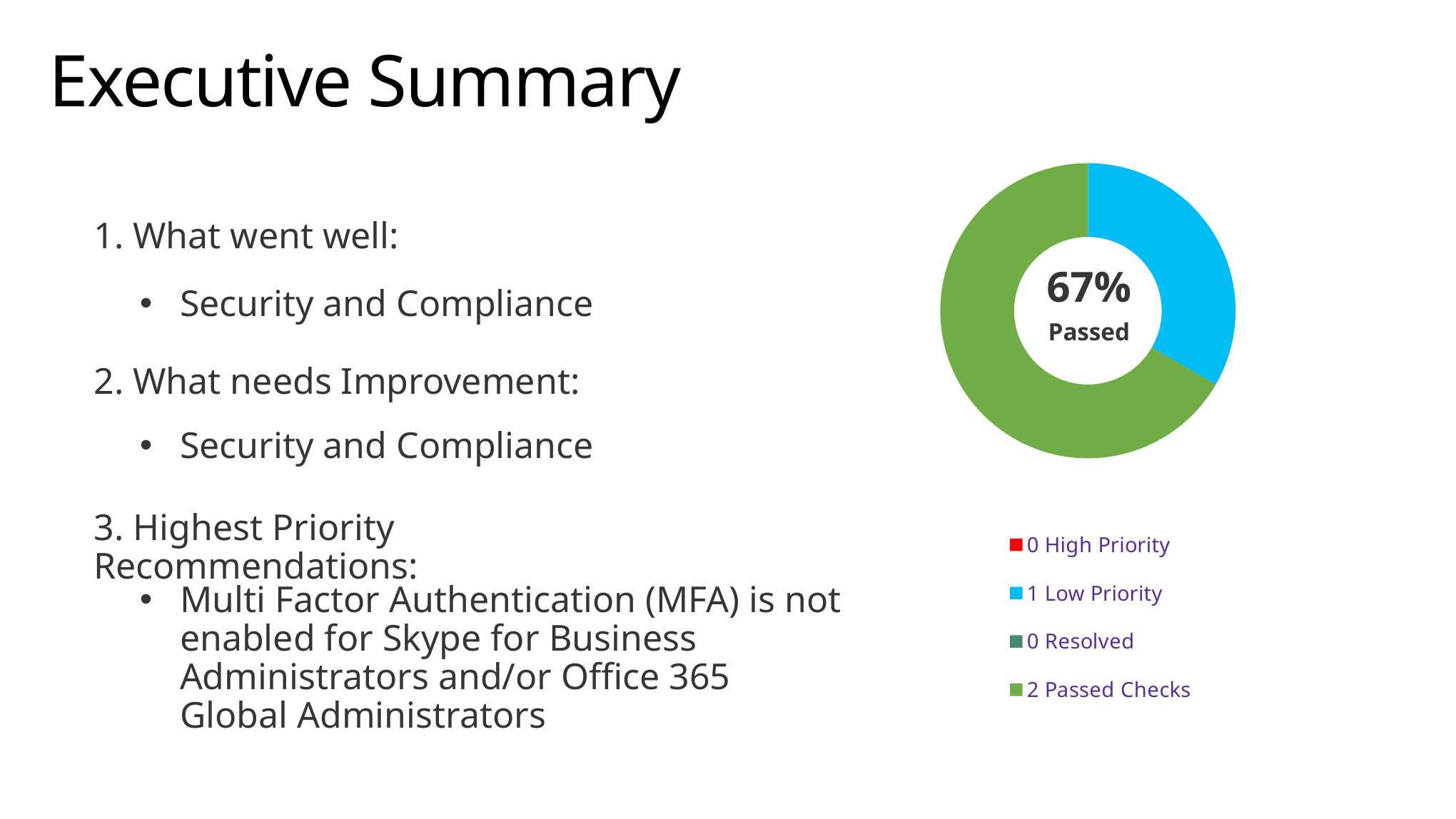
What kind of chart is shown on the slide? Donut chart How many Resolved items does the legend show? 0 How many High Priority items does the legend show? 0 How many Low Priority items does the legend show? 1 What colour represents Passed Checks in the donut chart? Green What word appears below the percentage in the centre of the donut chart? Passed How many Passed Checks does the legend show? 2 How many entries does the chart's legend list? 4 What is the difference between the number of Passed Checks and the number of Low Priority items? 1 Which legend category has the highest count? Passed Checks Which is larger, the count of Passed Checks or the count of Low Priority items? Passed Checks What percentage is shown in the centre of the donut chart? 67%